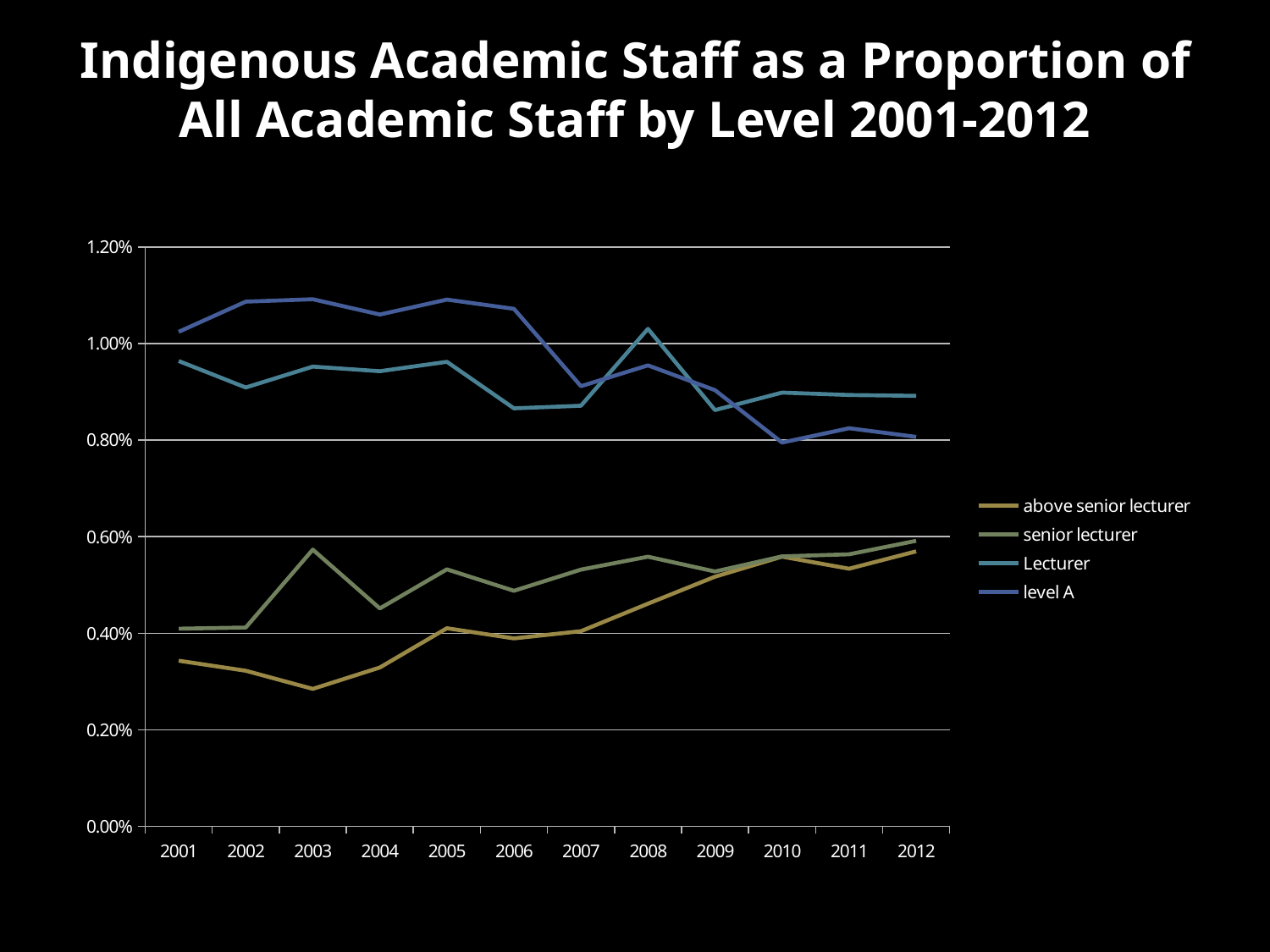
How many years are plotted along the x axis? 12 How many series does the legend list? 4 Is the value for level A in 2002 greater or less than 1.00%? greater In which year is the above senior lecturer series at its lowest? 2003 Which series has the lowest value in 2001? above senior lecturer In 2001, which is larger: the value for level A or the value for Lecturer? level A Does the level A series rise or fall overall from 2001 to 2012? fall Does the above senior lecturer series rise or fall overall from 2001 to 2012? rise What kind of chart is shown on the slide? line chart In 2012, which is larger: the value for Lecturer or the value for level A? Lecturer Is the value for above senior lecturer in 2003 greater or less than 0.40%? less